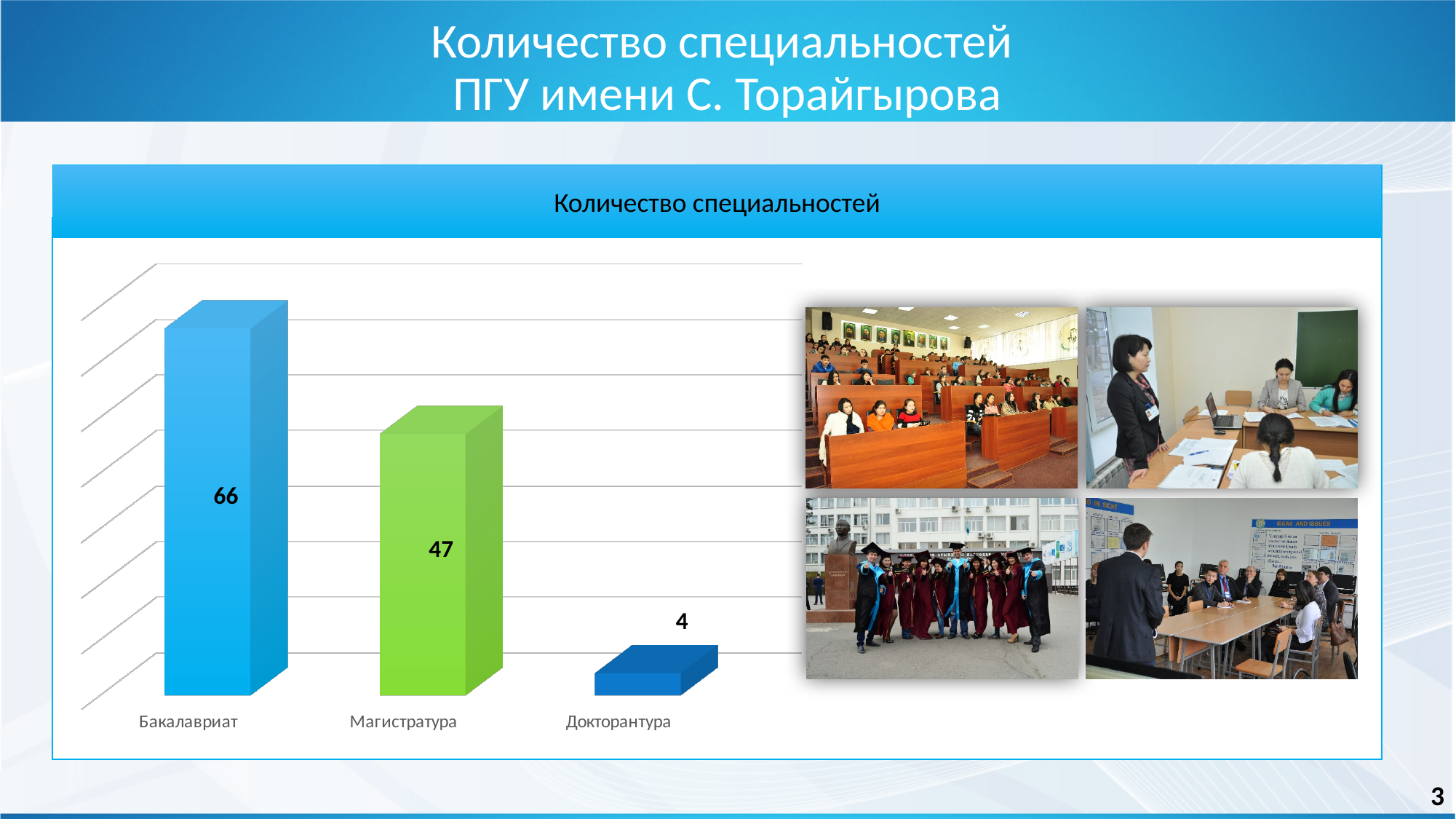
What is the difference between the values for Бакалавриат and Магистратура? 19 What kind of chart is shown on the slide? bar chart Which category has the lowest value? Докторантура Which is larger, the value for Магистратура or the value for Докторантура? Магистратура What is the value for Докторантура? 4 How many categories are shown on the chart? 3 What is the value for Бакалавриат? 66 What is the value for Магистратура? 47 What is the difference between the values for Магистратура and Докторантура? 43 Do the values rise or fall from left to right across the categories? fall Which category has the highest value? Бакалавриат What is the title of the chart? Количество специальностей